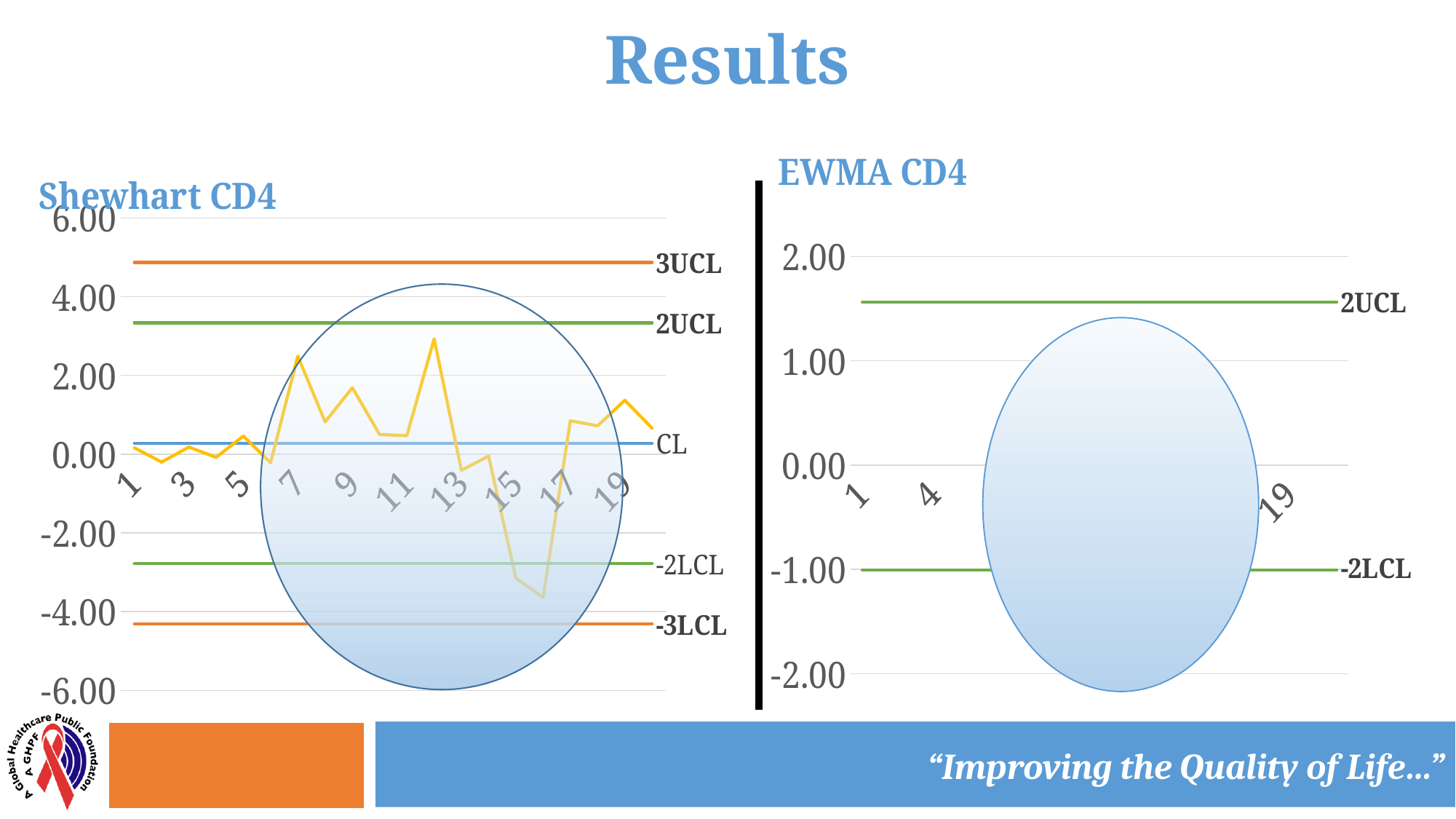
What kind of chart is the Shewhart CD4 chart? line chart On the Shewhart CD4 chart, is the value at point 7 greater or less than 2.00? greater On the Shewhart CD4 chart, which is larger, the value at point 7 or the value at point 3? point 7 On the Shewhart CD4 chart, is the 3UCL line greater or less than 4.00? greater On the Shewhart CD4 chart, which is larger, the value at point 9 or the value at point 15? point 9 On the Shewhart CD4 chart, is the value at point 15 greater or less than -2.00? less What is the highest value shown on the y axis of the Shewhart CD4 chart? 6.00 What is the highest value shown on the y axis of the EWMA CD4 chart? 2.00